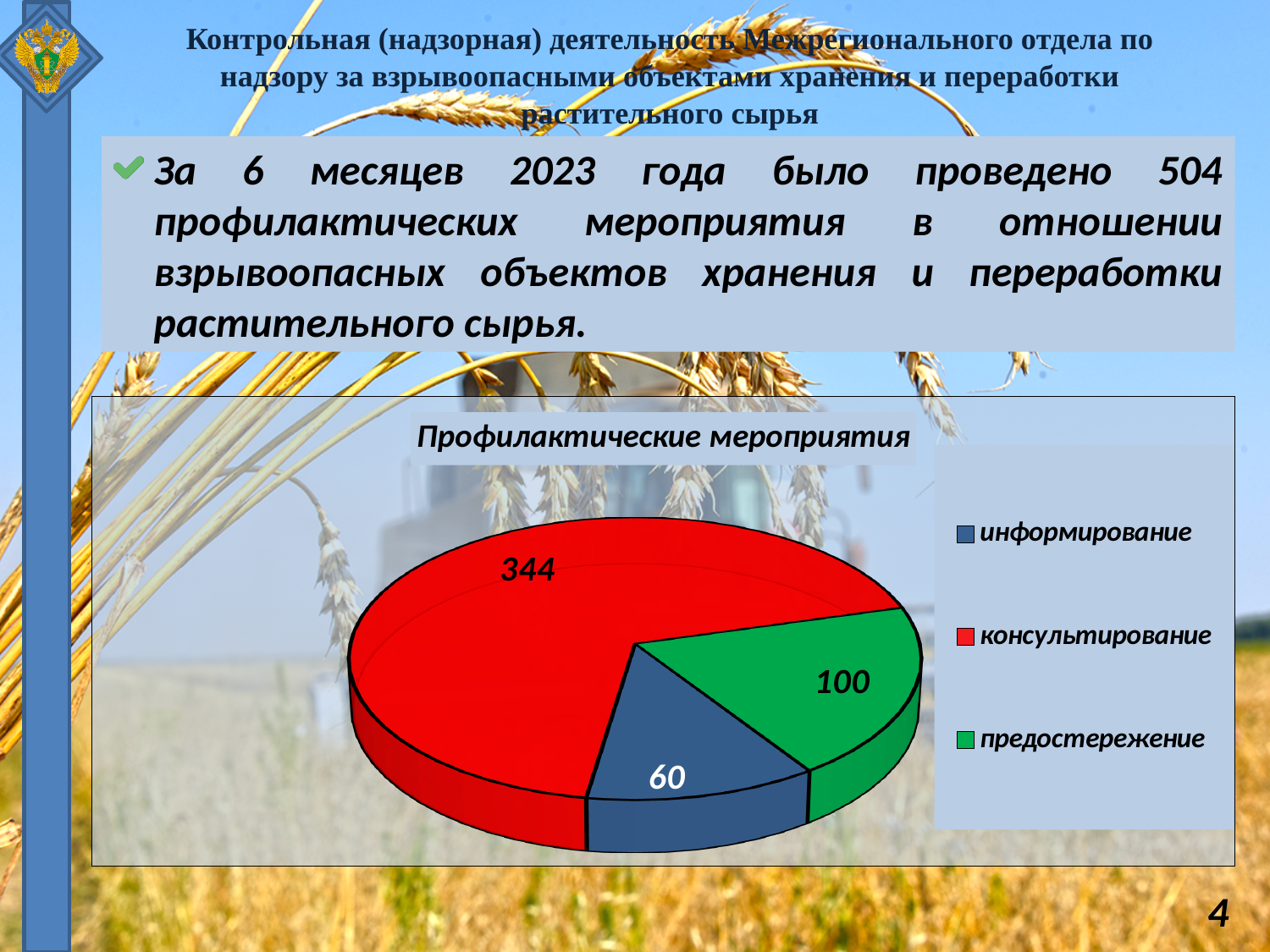
What is the difference between the values for предостережение and информирование? 40 What is the difference between the values for консультирование and предостережение? 244 Which is larger, предостережение or информирование? предостережение What is the value for информирование in the pie chart? 60 What is the value for предостережение in the pie chart? 100 Which category has the smallest slice in the pie chart? информирование What is the title of the chart? Профилактические мероприятия What is the total of all slices in the pie chart? 504 What is the value for консультирование in the pie chart? 344 What kind of chart is shown on the slide? pie chart Which category has the largest slice in the pie chart? консультирование How many categories does the pie chart show? 3